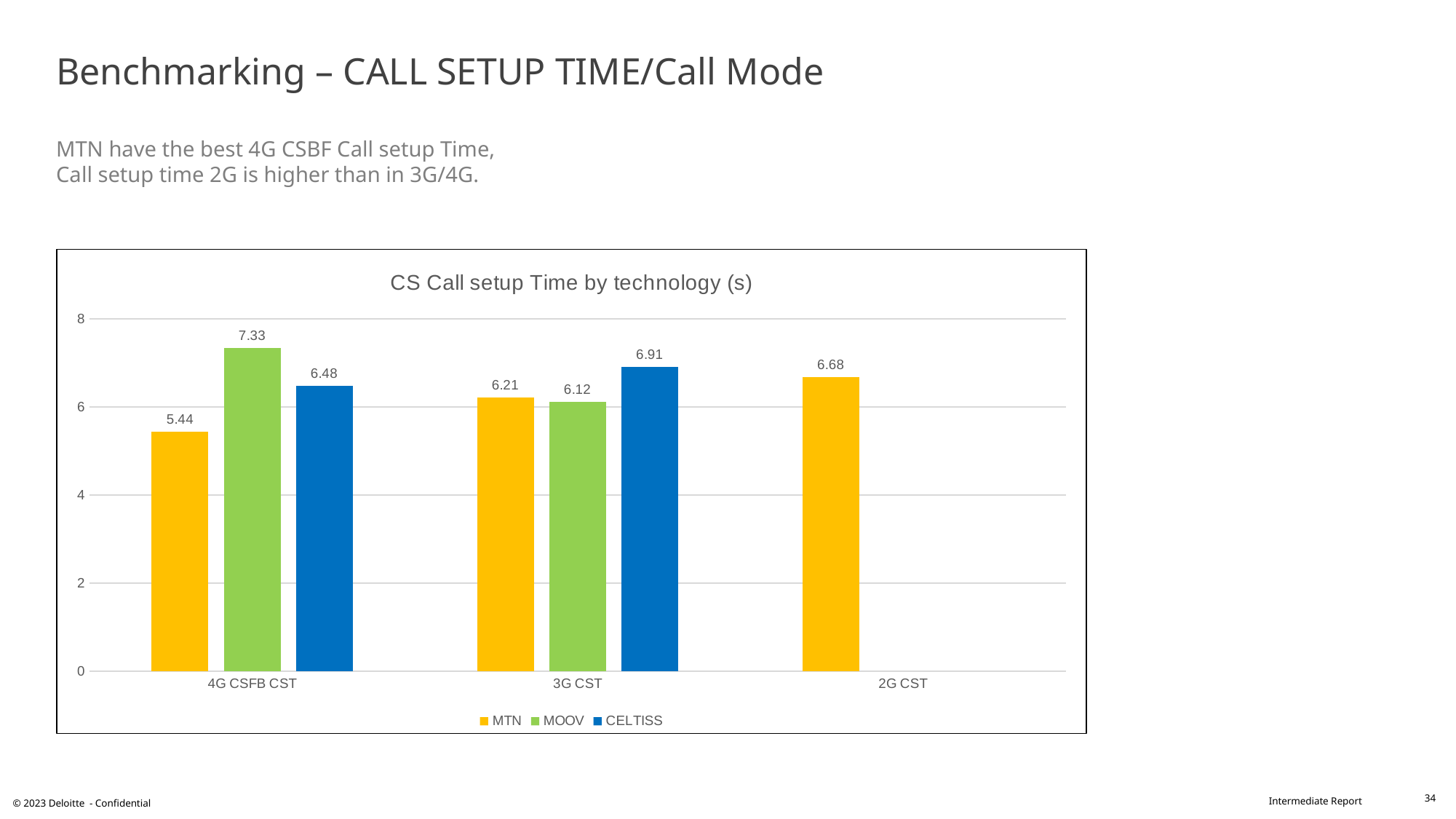
Which is larger for CELTISS: the 4G CSFB CST value or the 3G CST value? 3G CST What is the difference between the MOOV and MTN values for 4G CSFB CST? 1.89 What is the CELTISS value for 3G CST? 6.91 What is the MOOV value for 3G CST? 6.12 What is the title of the chart? CS Call setup Time by technology (s) Which operator has the highest call setup time for 4G CSFB CST? MOOV What kind of chart is shown on the slide? Bar chart What is the MTN value for 4G CSFB CST? 5.44 Which operator has the lowest call setup time for 3G CST? MOOV What is the MTN value for 2G CST? 6.68 How many categories are shown on the x axis? 3 How many series does the legend list? 3